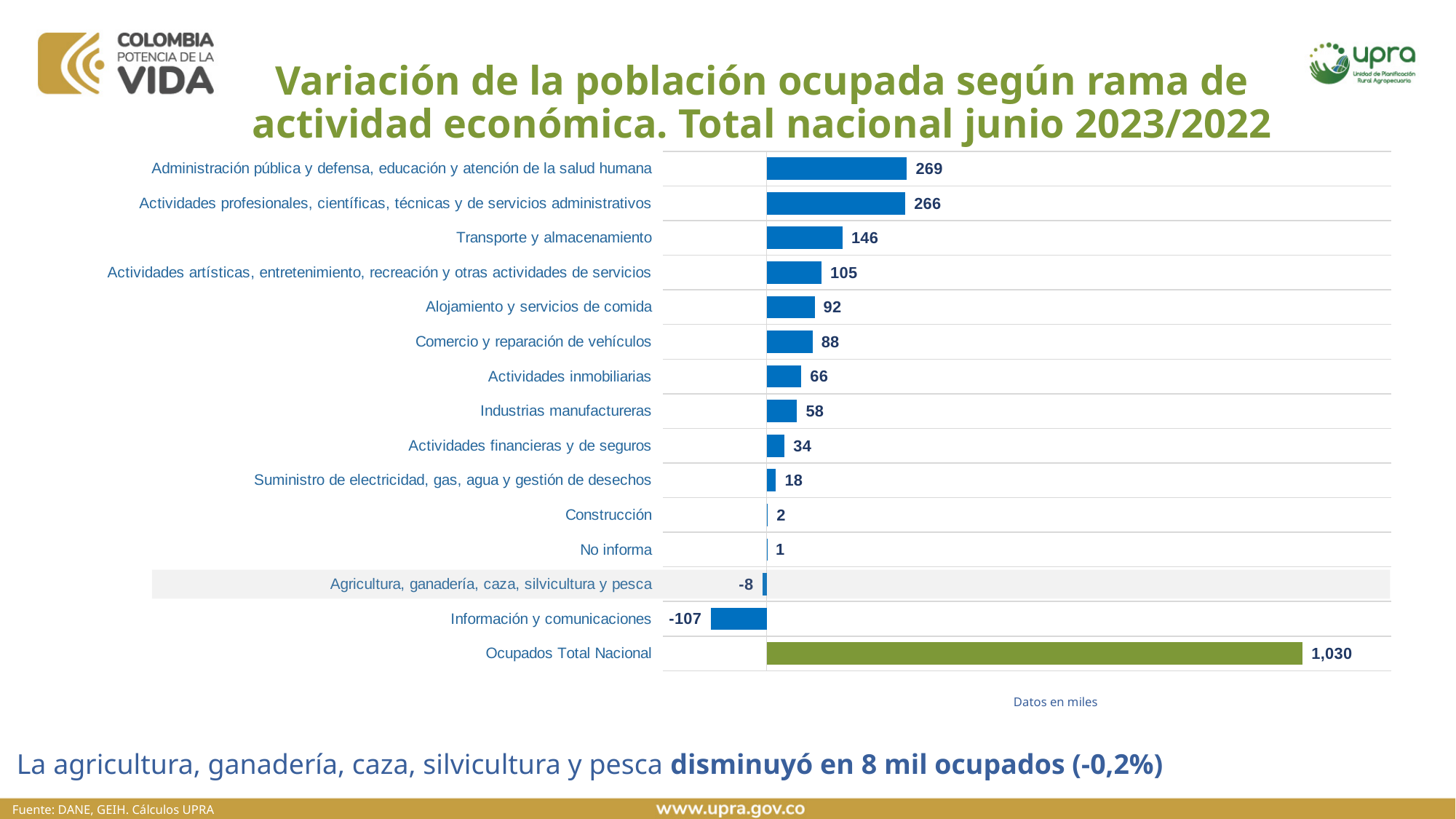
What is the difference between the values for Transporte y almacenamiento and Actividades artísticas, entretenimiento, recreación y otras actividades de servicios? 41 How many categories are shown in the chart? 15 What is the difference between the values for Administración pública y defensa, educación y atención de la salud humana and Actividades profesionales, científicas, técnicas y de servicios administrativos? 3 What is the value for Ocupados Total Nacional? 1,030 What is the value for Agricultura, ganadería, caza, silvicultura y pesca? -8 Which category has the lowest value? Información y comunicaciones What is the value for Transporte y almacenamiento? 146 In what units are the data in the chart expressed, according to the note below it? Datos en miles Excluding Ocupados Total Nacional, which rama de actividad has the highest value? Administración pública y defensa, educación y atención de la salud humana What kind of chart is shown on the slide? Bar chart Which is larger, the value for Alojamiento y servicios de comida or the value for Comercio y reparación de vehículos? Alojamiento y servicios de comida What is the value for Información y comunicaciones? -107